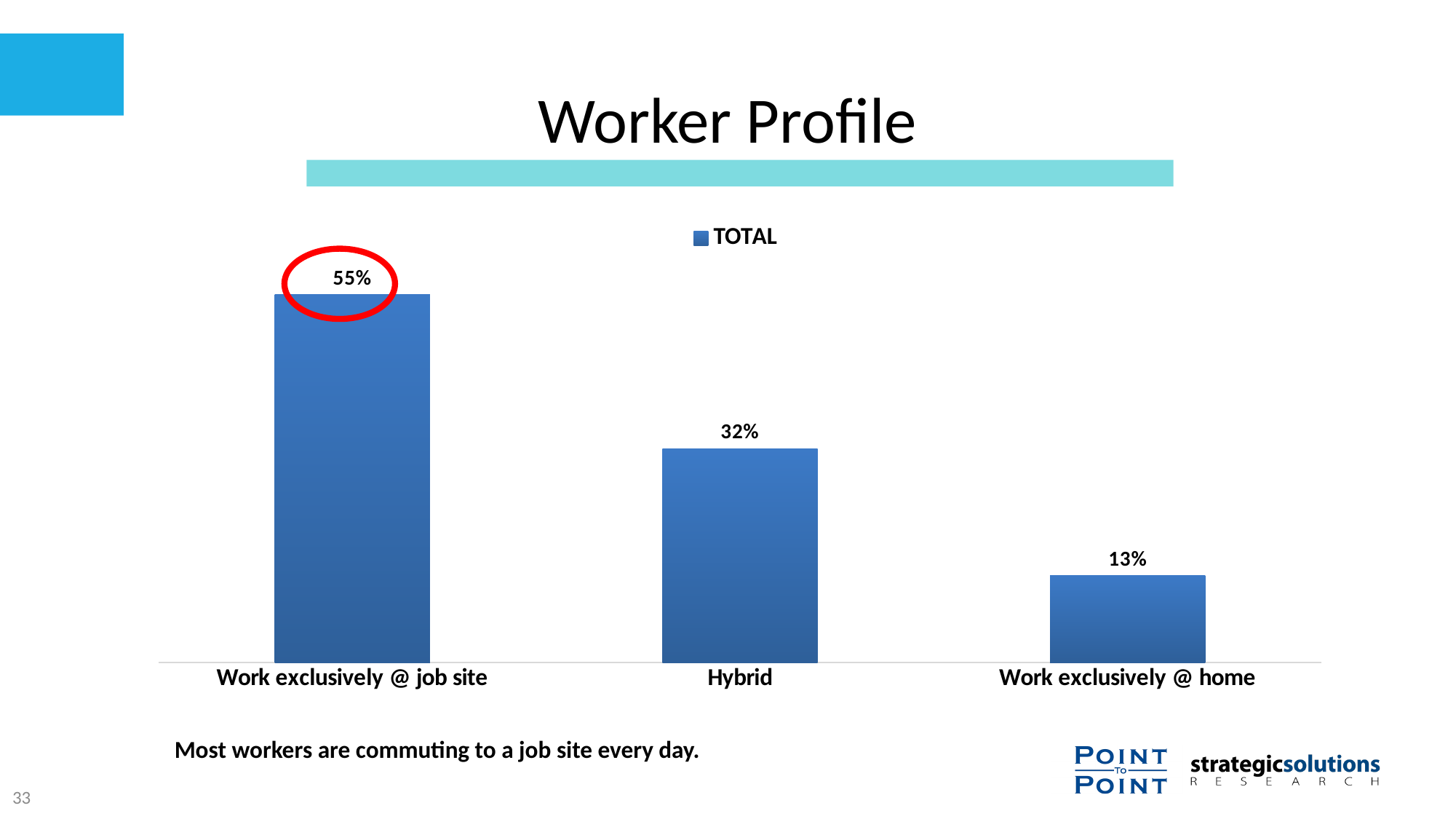
What is the name of the series listed in the legend? TOTAL What is the value for Work exclusively @ home? 13% Which category has the lowest value? Work exclusively @ home Which is larger, the value for Hybrid or the value for Work exclusively @ home? Hybrid What is the difference between the values for Work exclusively @ job site and Hybrid? 23% What kind of chart is shown on the slide? Bar chart Which category has the highest value? Work exclusively @ job site What is the value for Work exclusively @ job site? 55% How many categories are shown on the chart? 3 What is the value for Hybrid? 32% What is the difference between the values for Hybrid and Work exclusively @ home? 19% How many series does the legend list? 1